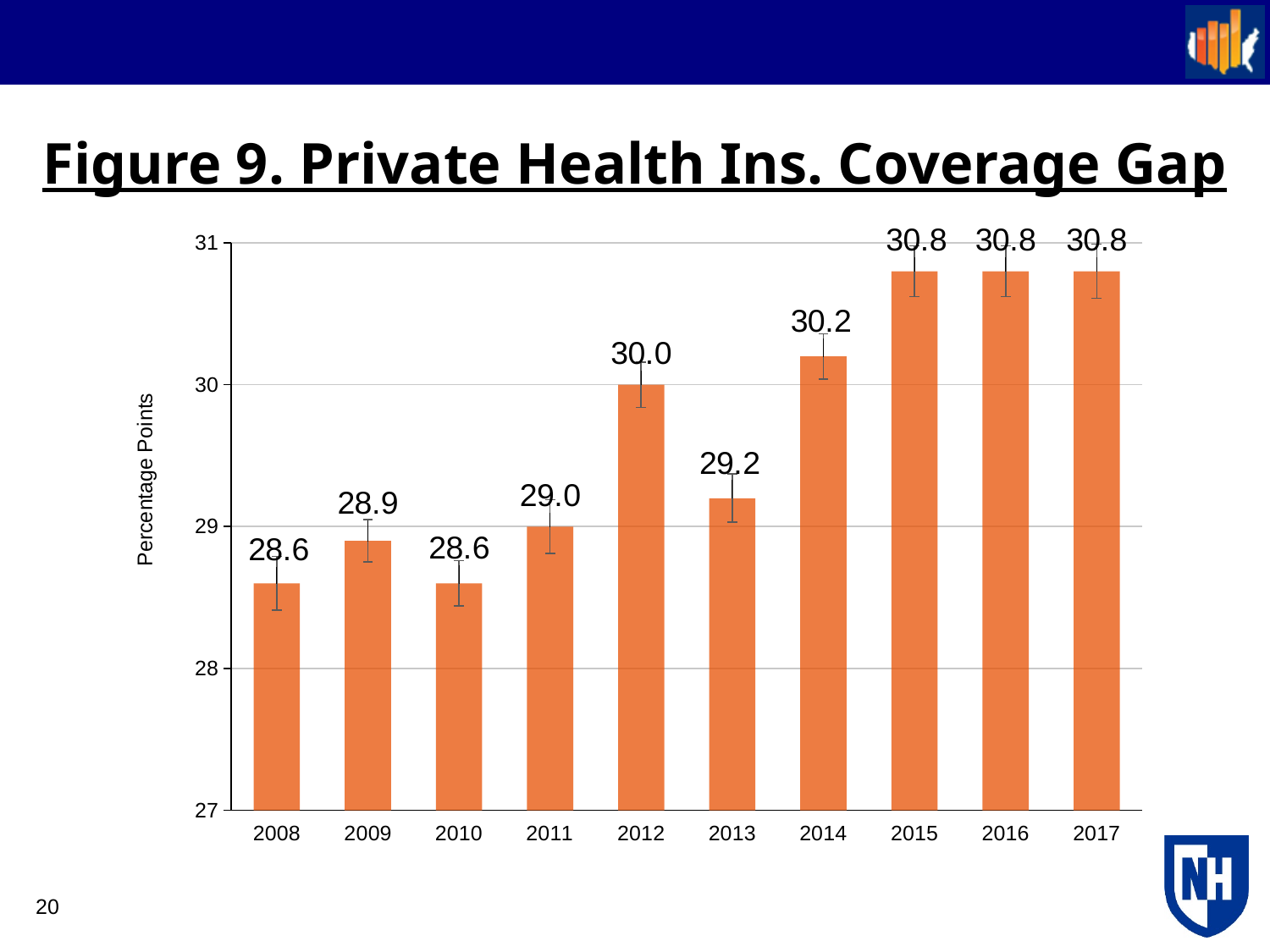
What is the value for 2013? 29.2 Is the value for 2009 greater or less than 29? less What is the label of the y axis? Percentage Points How many years are shown on the x axis? 10 Which is larger, the value for 2011 or the value for 2014? 2014 What is the value for 2014? 30.2 What kind of chart is this? bar chart What is the value for 2012? 30.0 Which year has the lowest value? 2008 and 2010 What is the value for 2008? 28.6 What is the difference between the values for 2012 and 2013? 0.8 What is the difference between the values for 2017 and 2008? 2.2